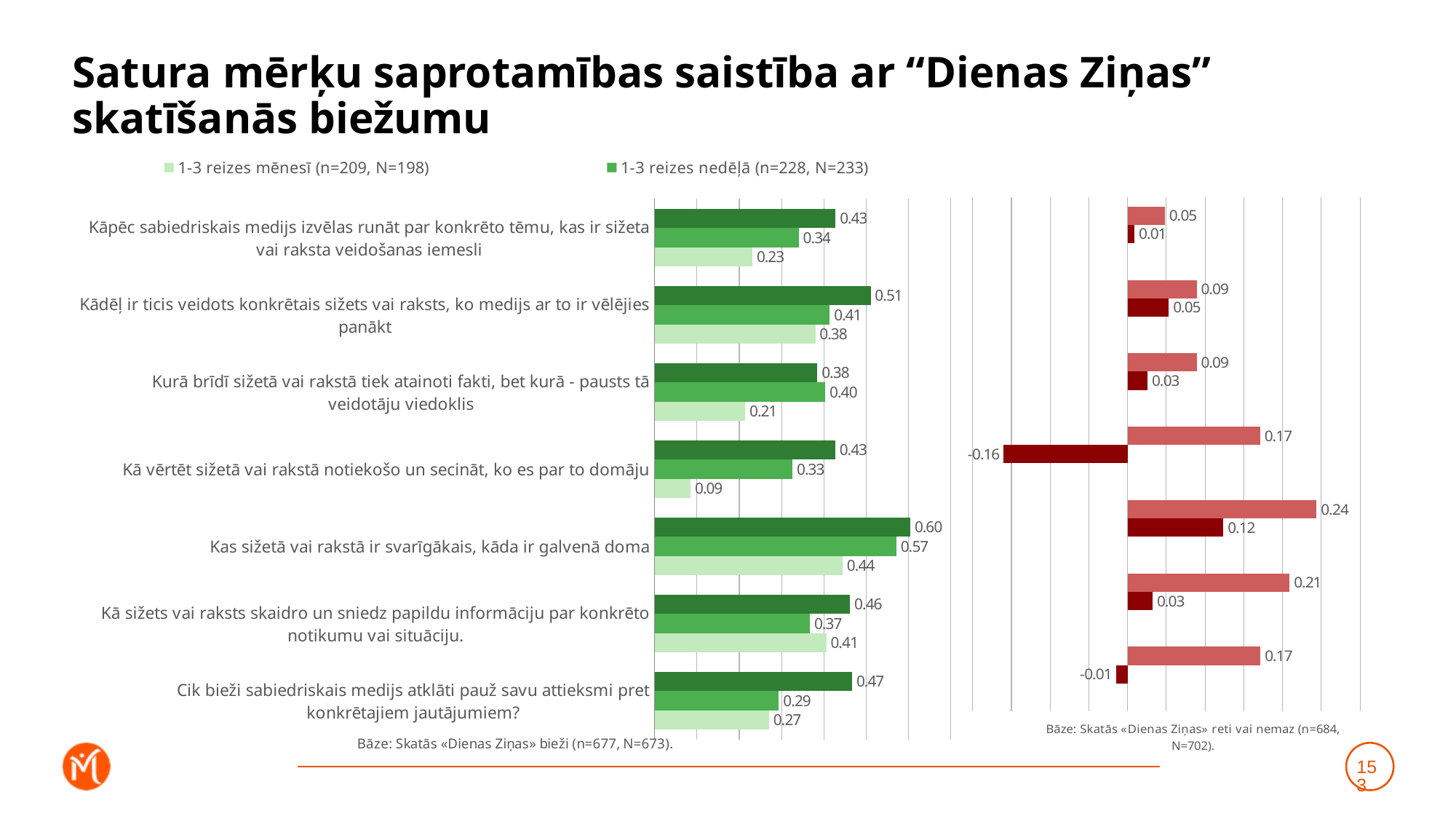
In the left (green) chart, what is the value for '1-3 reizes mēnesī' for the category 'Kas sižetā vai rakstā ir svarīgākais, kāda ir galvenā doma'? 0.44 In the right (red) chart, what is the highest value shown? 0.24 What is the base note printed under the left (green) chart? Bāze: Skatās «Dienas Ziņas» bieži (n=677, N=673). In the left (green) chart, what is the value for '1-3 reizes nedēļā' for the category 'Kā vērtēt sižetā vai rakstā notiekošo un secināt, ko es par to domāju'? 0.33 How many categories are shown in the left (green) chart? 7 In the left (green) chart, which category has the lowest value for '1-3 reizes mēnesī'? Kā vērtēt sižetā vai rakstā notiekošo un secināt, ko es par to domāju In the left (green) chart, what is the difference between the '1-3 reizes nedēļā' value and the '1-3 reizes mēnesī' value for 'Kas sižetā vai rakstā ir svarīgākais, kāda ir galvenā doma'? 0.13 In the left (green) chart, which category has the highest value for '1-3 reizes mēnesī'? Kas sižetā vai rakstā ir svarīgākais, kāda ir galvenā doma In the left (green) chart, which has the larger '1-3 reizes mēnesī' value: 'Kādēļ ir ticis veidots konkrētais sižets vai raksts, ko medijs ar to ir vēlējies panākt' or 'Kurā brīdī sižetā vai rakstā tiek atainoti fakti, bet kurā - pausts tā veidotāju viedoklis'? Kādēļ ir ticis veidots konkrētais sižets vai raksts, ko medijs ar to ir vēlējies panākt How many series does the legend at the top of the slide list? 2 What kind of chart is the left (green) chart? Bar chart In the right (red) chart, which category has the value -0.16? Kā vērtēt sižetā vai rakstā notiekošo un secināt, ko es par to domāju